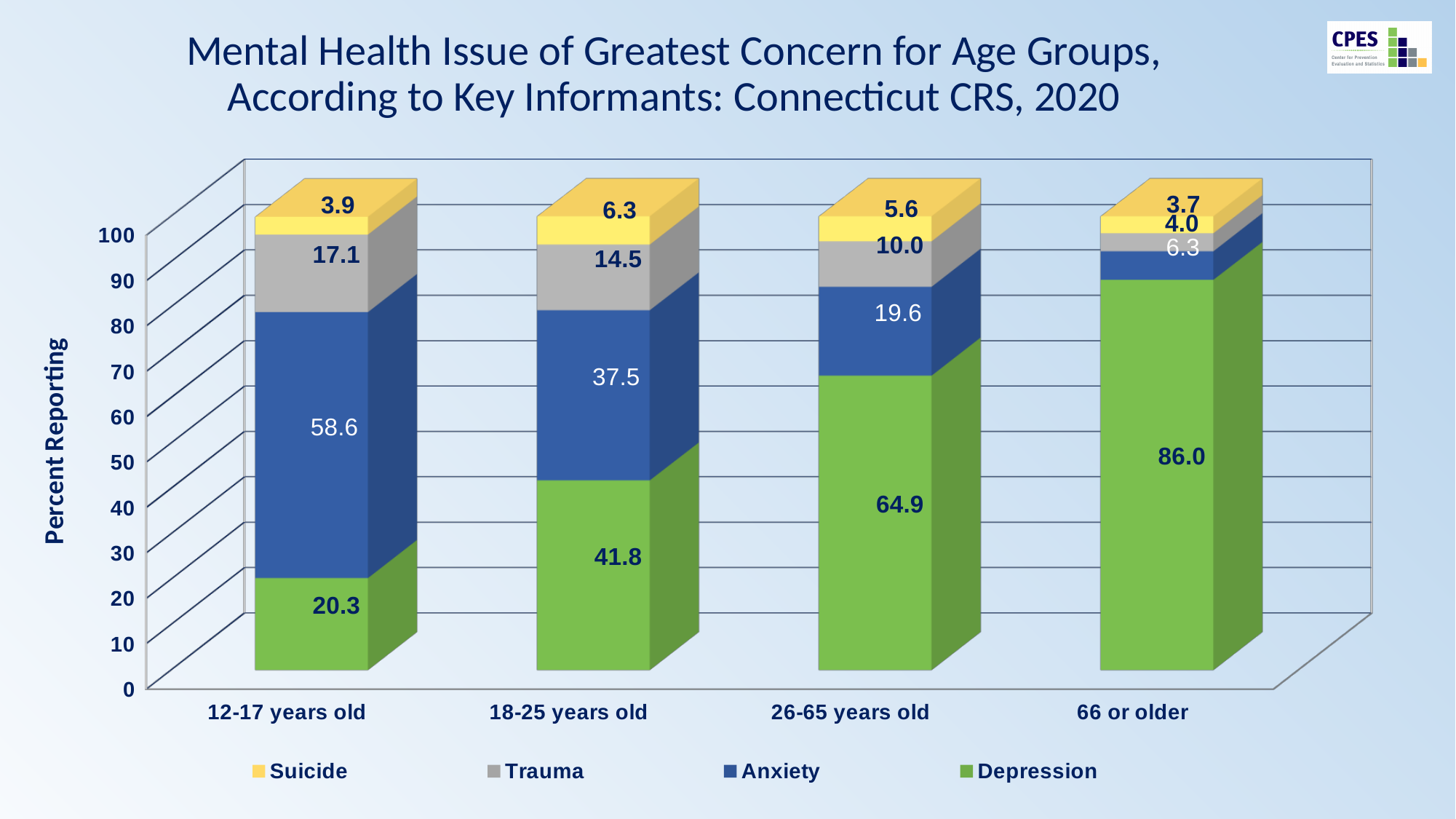
What kind of chart is shown on the slide? Stacked bar chart What is the Depression value for the 26-65 years old group? 64.9 Does the Depression value rise or fall as the age groups move from 12-17 years old to 66 or older? Rises What is the Anxiety value for the 12-17 years old group? 58.6 Which age group has the lowest Anxiety value? 66 or older How many series does the legend list? 4 Which age group has the highest Depression value? 66 or older What is the Suicide value for the 18-25 years old group? 6.3 For the 18-25 years old group, which is larger: Depression or Anxiety? Depression How many age groups are shown on the x axis? 4 What is the difference between the Depression value for 66 or older and the Depression value for 12-17 years old? 65.7 What is the Trauma value for the 66 or older group? 4.0